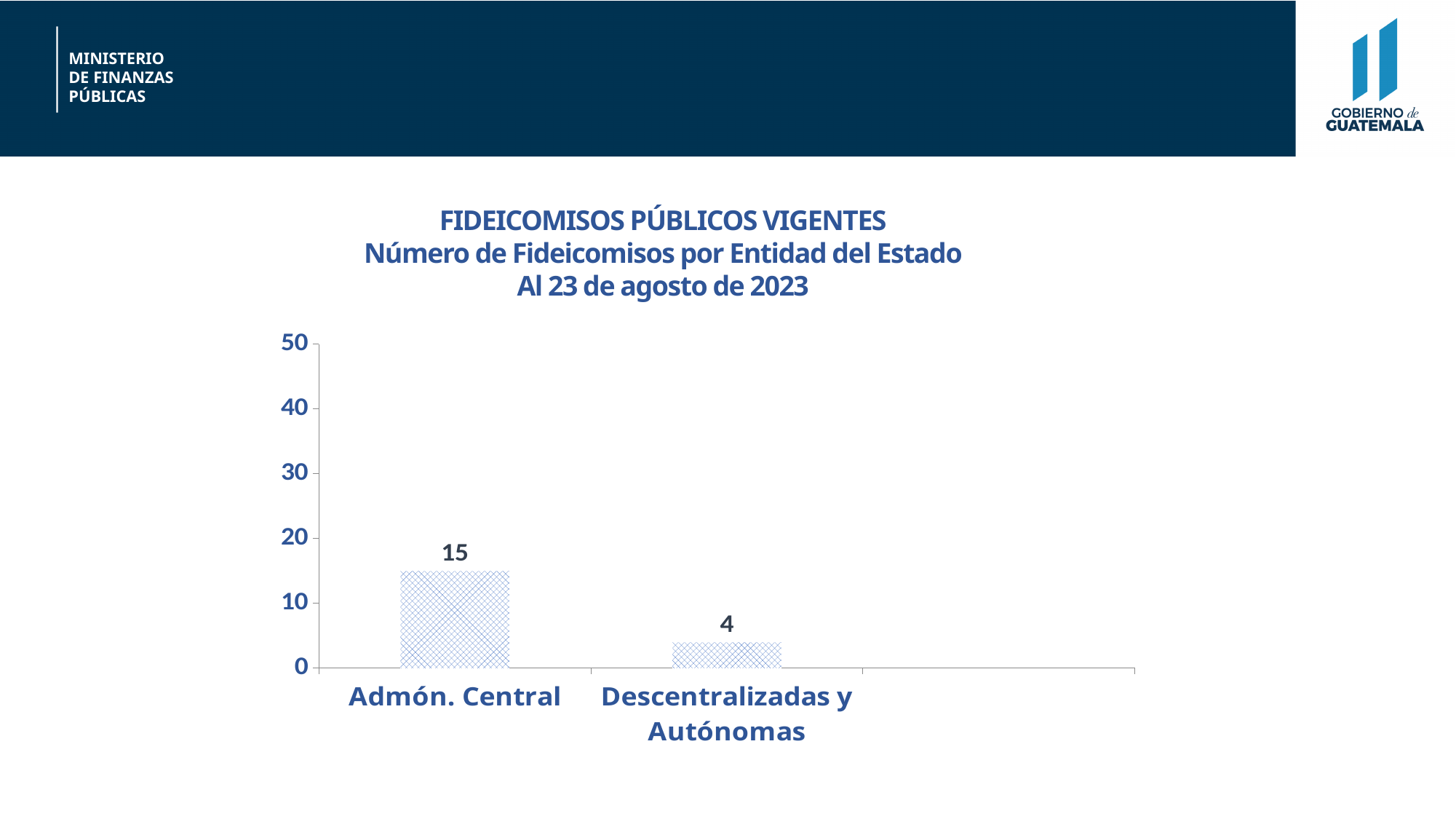
Which category has the highest value? Admón. Central What is the difference between the values for Admón. Central and Descentralizadas y Autónomas? 11 What is the value for Admón. Central? 15 Is the value for Descentralizadas y Autónomas greater or less than 10? less Which is larger, the value for Admón. Central or the value for Descentralizadas y Autónomas? Admón. Central How many categories are shown on the x axis? 2 What kind of chart is shown on the slide? bar chart Is the value for Admón. Central greater or less than 20? less Which category has the lowest value? Descentralizadas y Autónomas What is the value for Descentralizadas y Autónomas? 4 What is the total of the two values shown in the chart? 19 What date does the chart title say the data is as of? 23 de agosto de 2023